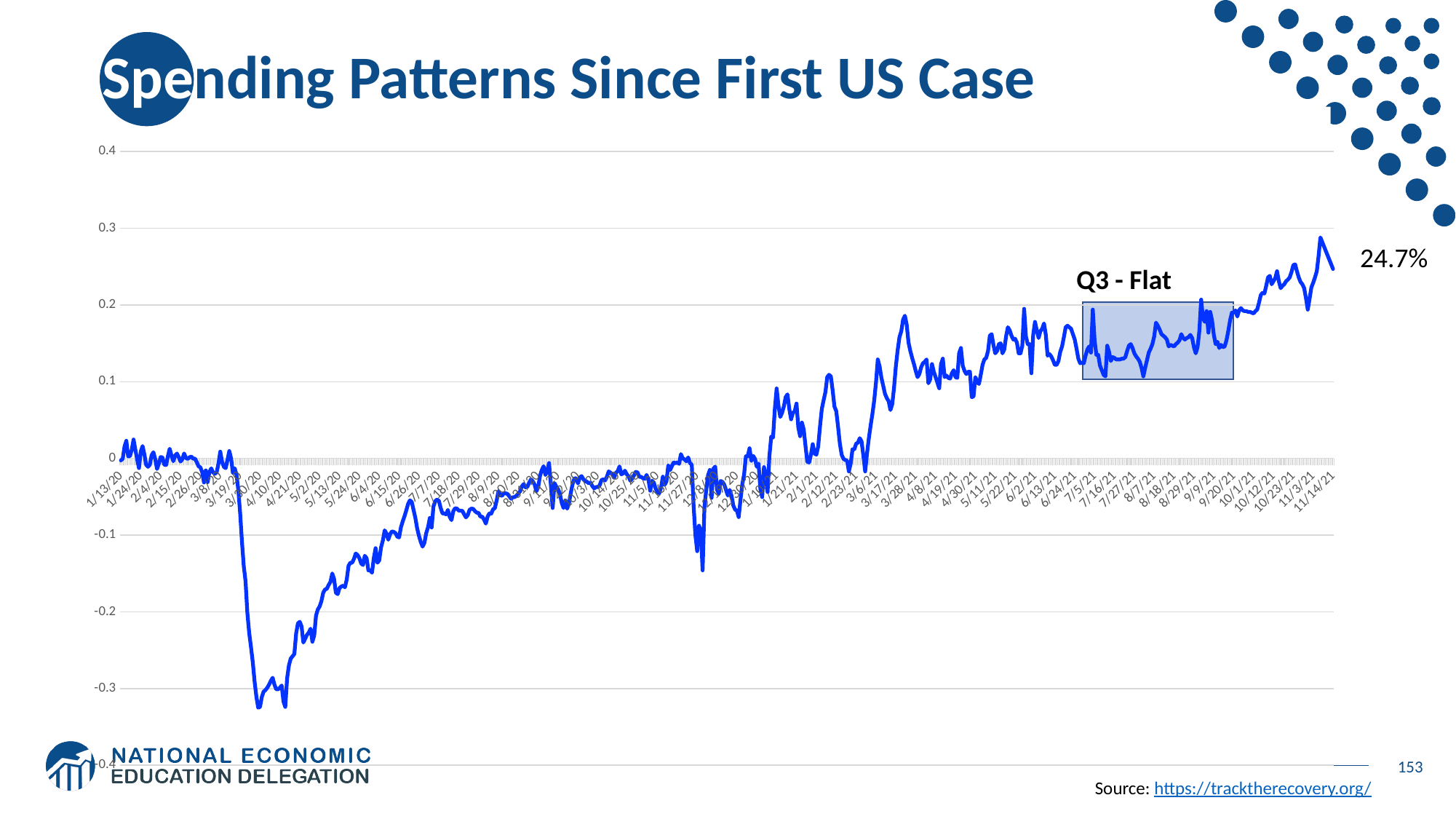
What text is written above the shaded box on the chart? Q3 - Flat Is the value at 7/5/21 greater or less than 0.1? greater What is the title of the chart on the slide? Spending Patterns Since First US Case What is the value labelled at the right end of the line? 24.7% Overall, does the line rise or fall from the start of the x axis to the end? rise Is the value at 11/14/21 greater or less than 0.2? greater Which is larger, the value at 1/13/20 or the value at 11/14/21? 11/14/21 What kind of chart is shown on the slide? line chart Which is larger, the value at 4/10/20 or the value at 10/12/21? 10/12/21 Is the value at 8/9/20 greater or less than 0? less Does the lowest point of the line occur in 2020 or in 2021? 2020